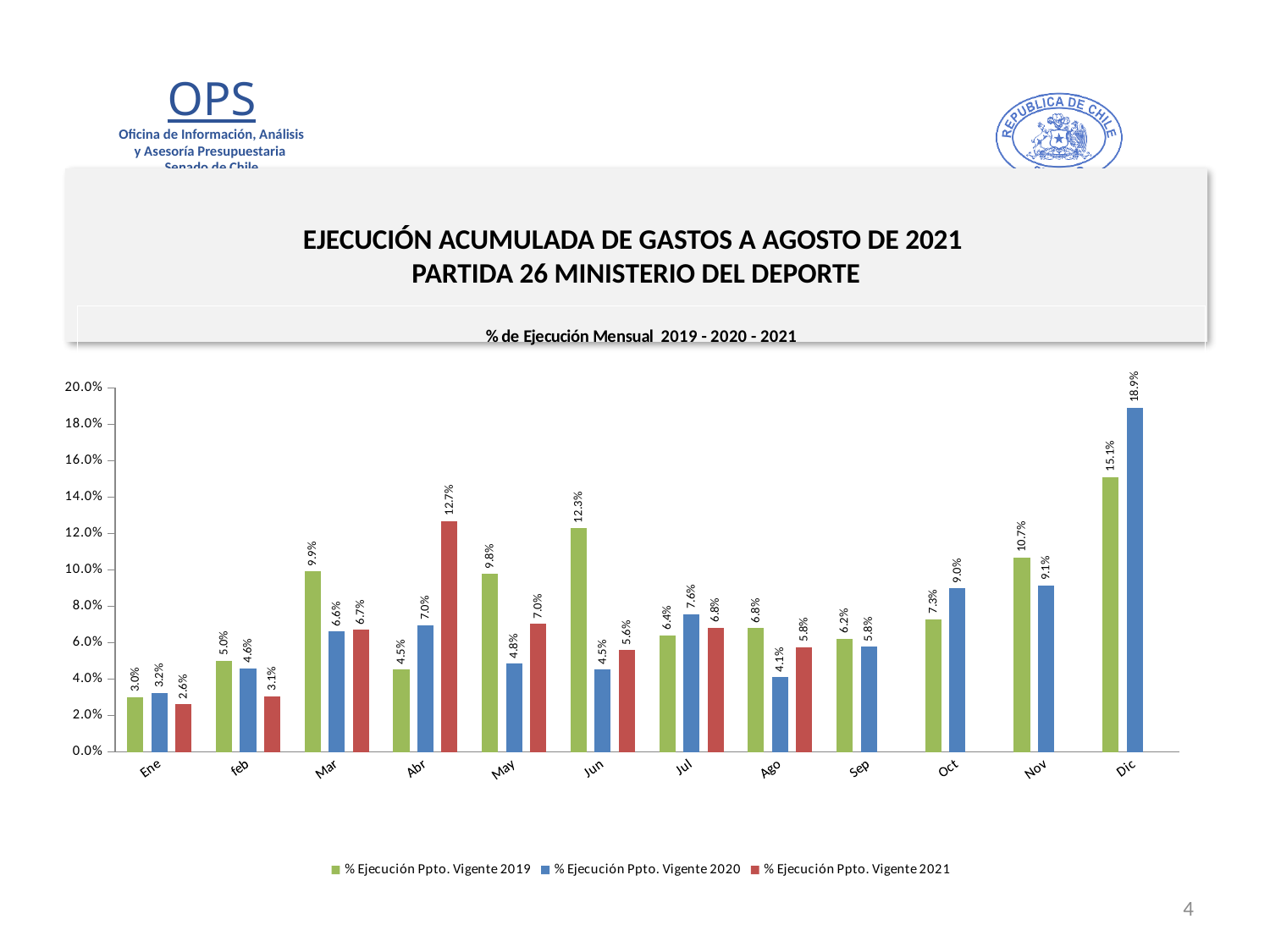
What is the value for % Ejecución Ppto. Vigente 2021 in Abr? 12.7% How many series does the legend list? 3 In which month is the % Ejecución Ppto. Vigente 2021 value lowest? Ene Which is larger in Mar: the 2019 value or the 2020 value? 2019 value Which colour represents % Ejecución Ppto. Vigente 2021? Red What is the title of the chart? % de Ejecución Mensual 2019 - 2020 - 2021 How many months are shown on the x axis? 12 What kind of chart is shown on the slide? Bar chart In which month is the % Ejecución Ppto. Vigente 2019 value highest? Dic What is the difference between the 2020 and 2019 values in Dic? 3.8% What is the value for % Ejecución Ppto. Vigente 2019 in Jun? 12.3% What is the value for % Ejecución Ppto. Vigente 2020 in Dic? 18.9%